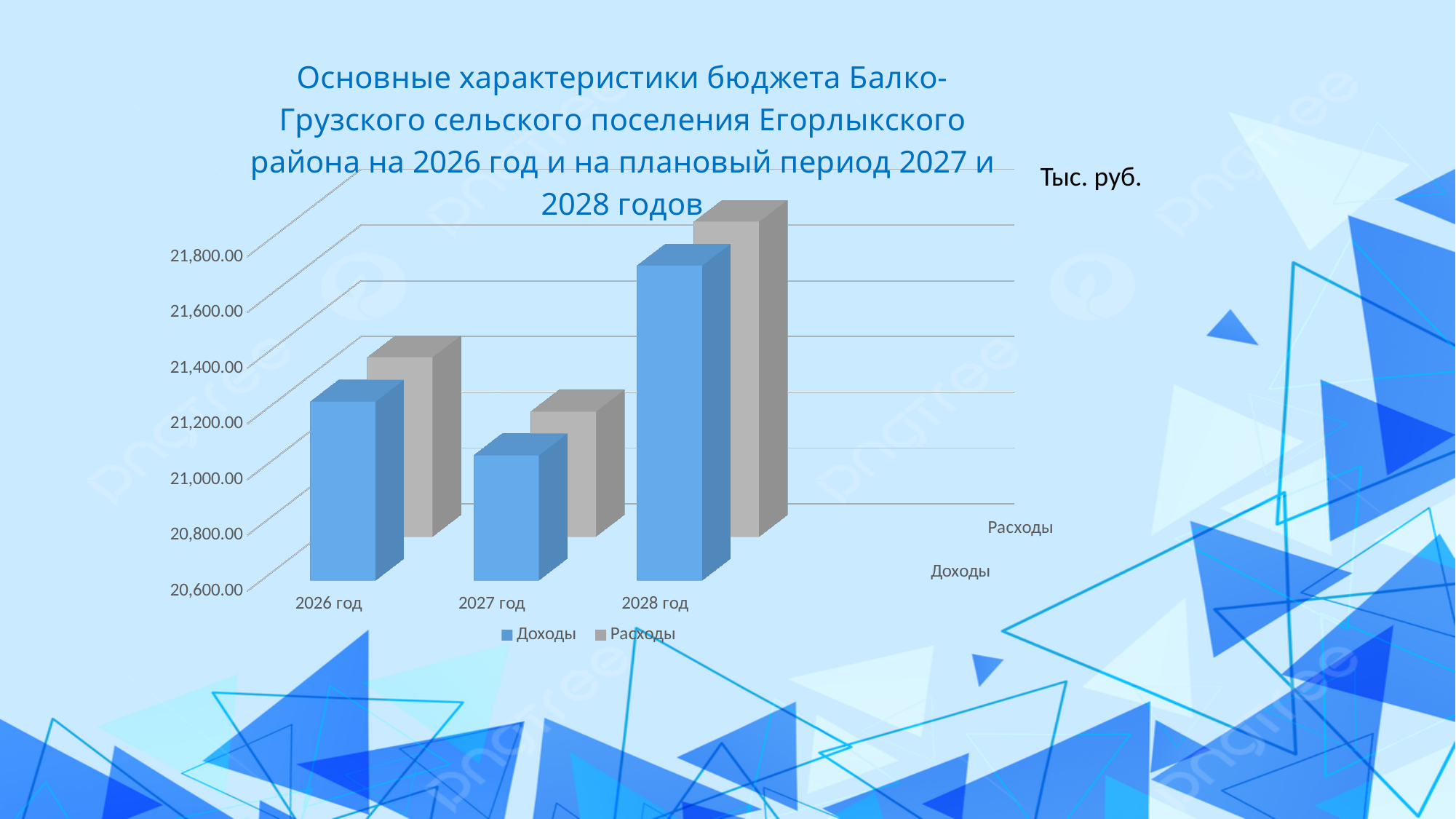
What kind of chart is shown on the slide? bar chart Which year has the highest value for Доходы? 2028 год Do the values for Доходы rise or fall from 2027 год to 2028 год? rise How many series does the chart legend list? 2 Which year has the lowest value for Расходы? 2027 год Is the value for Доходы in 2027 год greater or less than 21,200.00? less Is the value for Доходы in 2028 год greater or less than 21,600.00? greater Which year has the highest value for Расходы? 2028 год How many year categories are shown on the x axis of the chart? 3 Which year has the lowest value for Доходы? 2027 год What unit label is shown next to the chart? Тыс. руб.